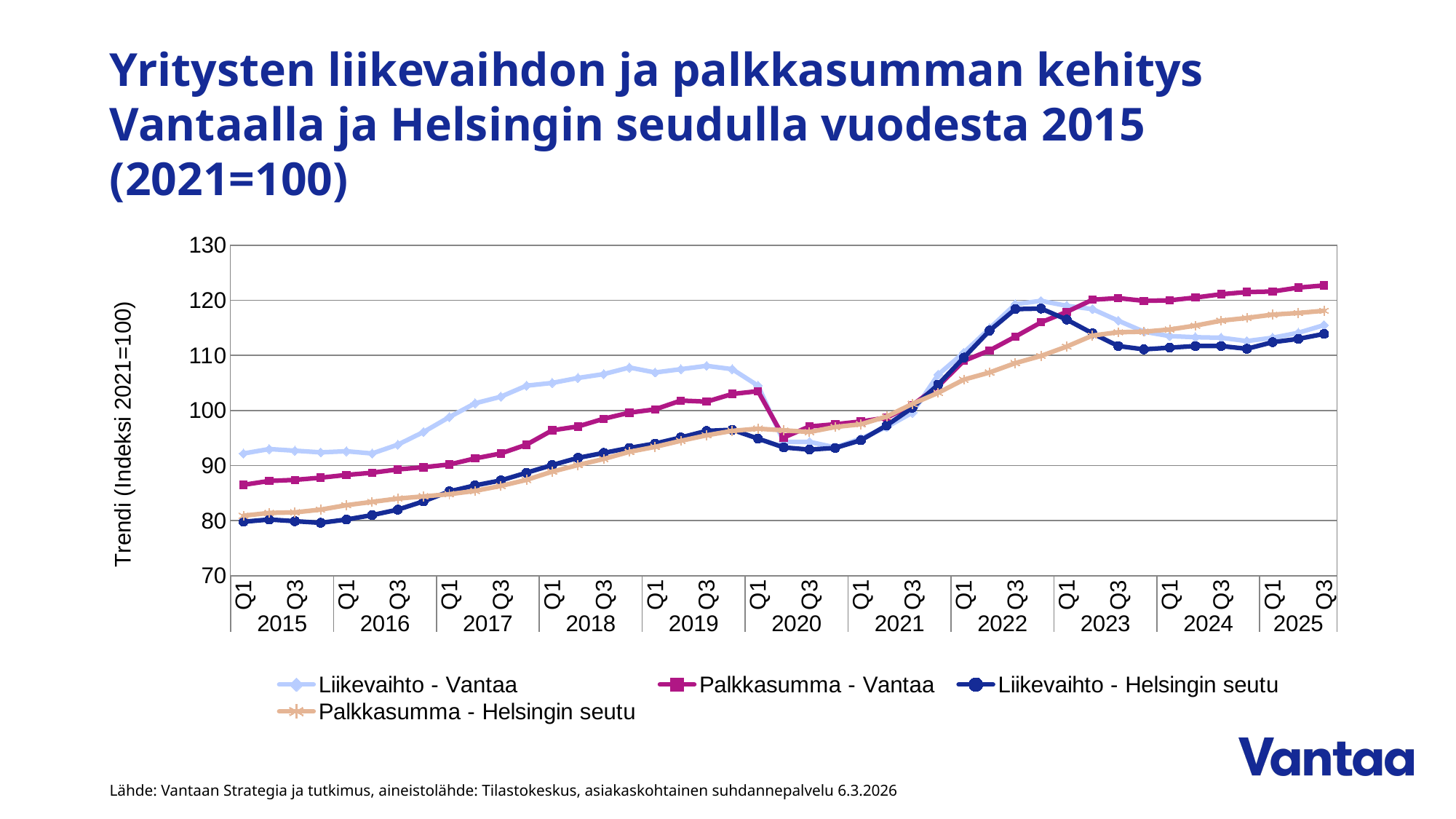
Is the value for Liikevaihto - Vantaa at Q3 2019 greater or less than 110? less How many years are labelled on the x axis? 11 Is the value for Palkkasumma - Helsingin seutu at Q3 2025 greater or less than 120? less What is the label of the y axis? Trendi (Indeksi 2021=100) Does the Liikevaihto - Vantaa series rise or fall from Q1 2023 to Q3 2024? fall Is the value for Palkkasumma - Vantaa at Q3 2025 greater or less than 120? greater Which series has the highest value at Q3 2025? Palkkasumma - Vantaa How many series does the legend list? 4 At Q1 2015, which is larger: Liikevaihto - Vantaa or Palkkasumma - Vantaa? Liikevaihto - Vantaa What kind of chart is shown on the slide? line chart Does the Palkkasumma - Vantaa series rise or fall overall from 2015 to 2025? rise